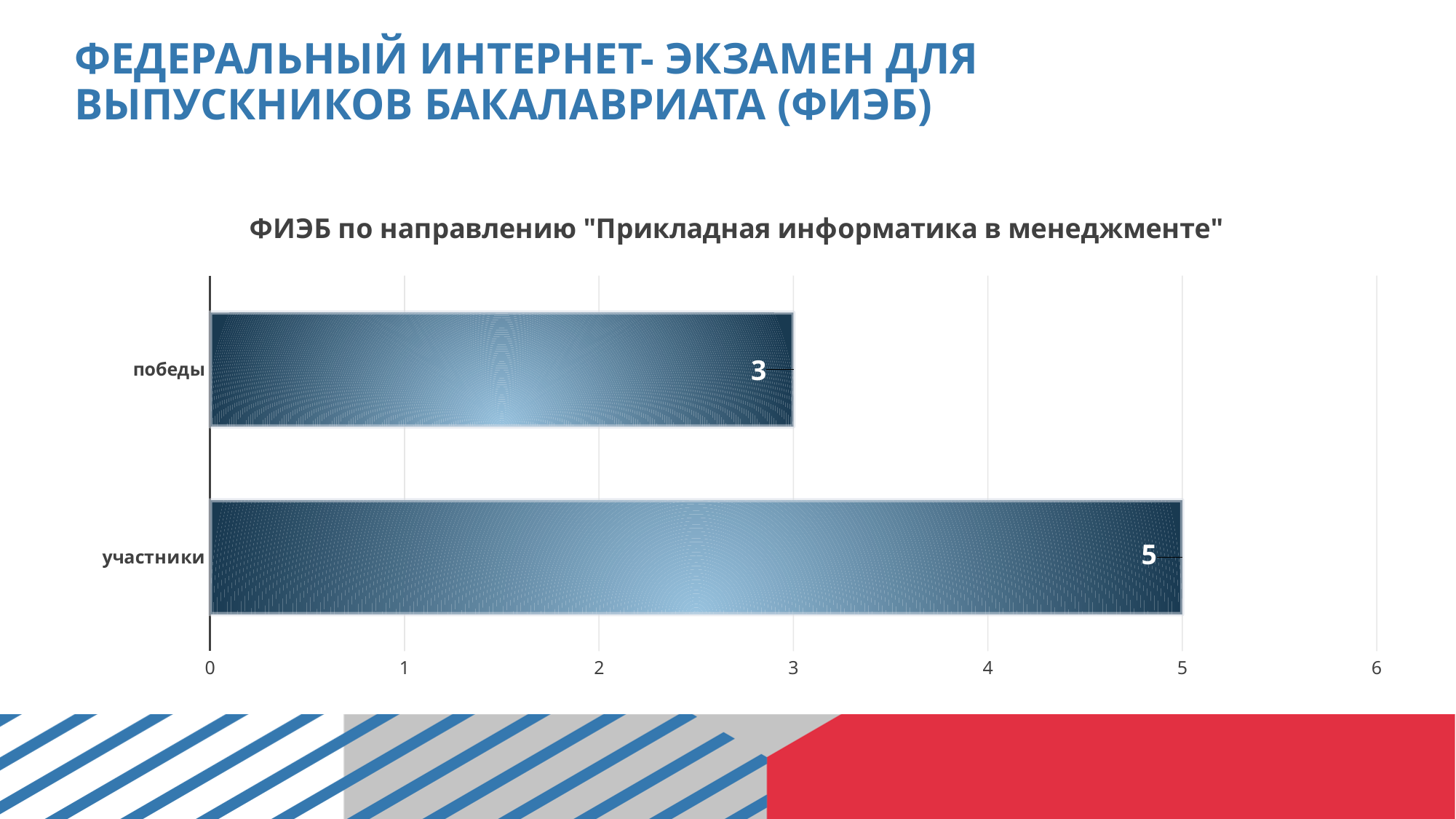
What is the value for победы? 3 Is the value for победы greater or less than 4? less Which category has the highest value? участники What is the maximum value shown on the horizontal axis? 6 Which is larger, the value for победы or the value for участники? участники What kind of chart is shown on the slide? bar chart What is the difference between the values for участники and победы? 2 How many categories are shown in the chart? 2 Is the value for участники greater or less than 4? greater What is the title of the chart? ФИЭБ по направлению "Прикладная информатика в менеджменте" Which category has the lowest value? победы What is the value for участники? 5